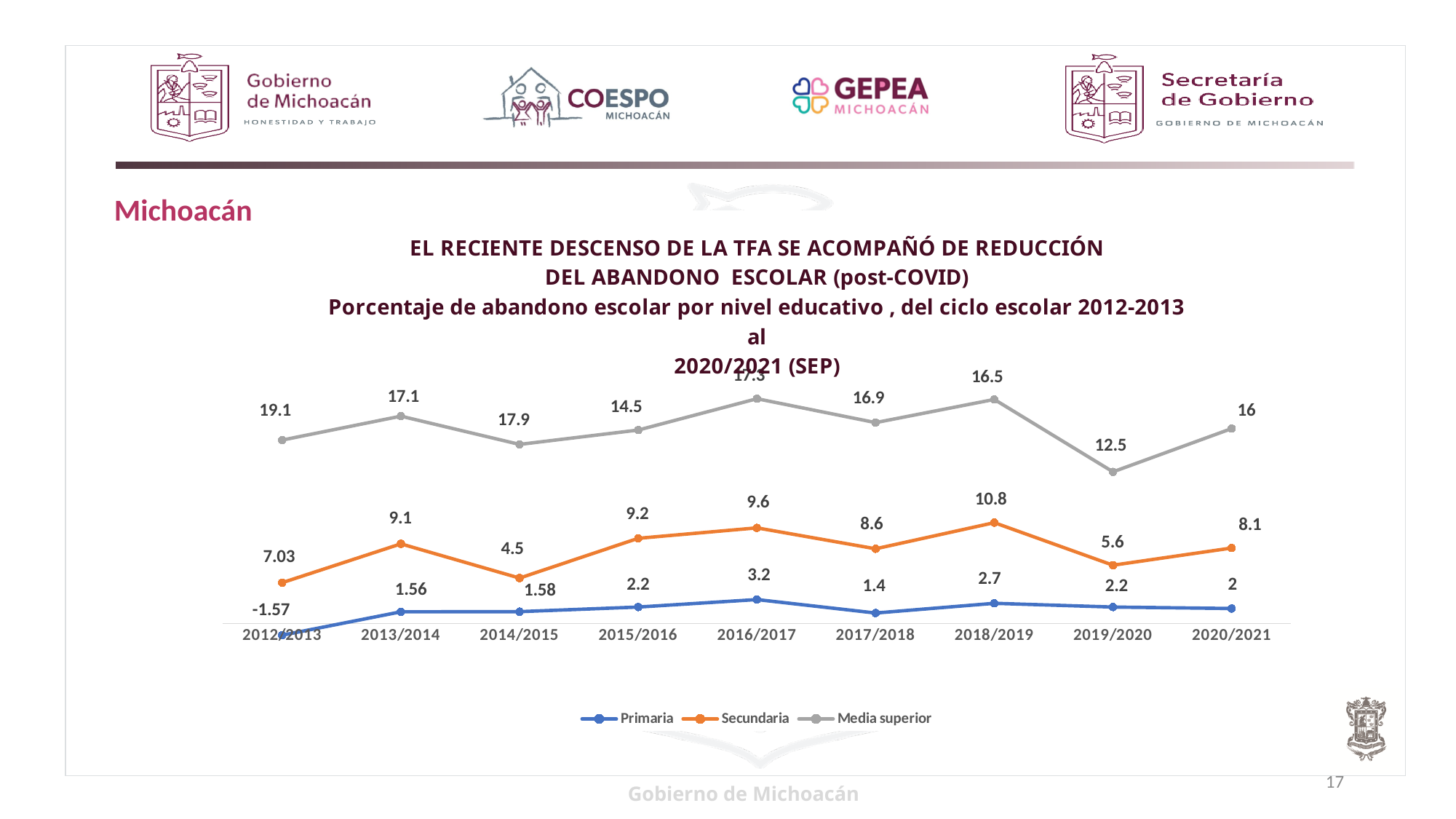
Which is larger for Secundaria: the value for 2014/2015 or the value for 2019/2020? 2019/2020 How many school cycles are shown on the x axis? 9 What is the difference between the Media superior values for 2012/2013 and 2020/2021? 3.1 What is the Secundaria value for 2018/2019? 10.8 In which school cycle is the Media superior value lowest? 2019/2020 What is the Primaria value for 2012/2013? -1.57 What is the Media superior value for 2012/2013? 19.1 What kind of chart is shown on the slide? line chart How many series does the legend list? 3 What is the difference between the Secundaria values for 2018/2019 and 2019/2020? 5.2 What is the Primaria value for 2016/2017? 3.2 In which school cycle is the Secundaria value highest? 2018/2019